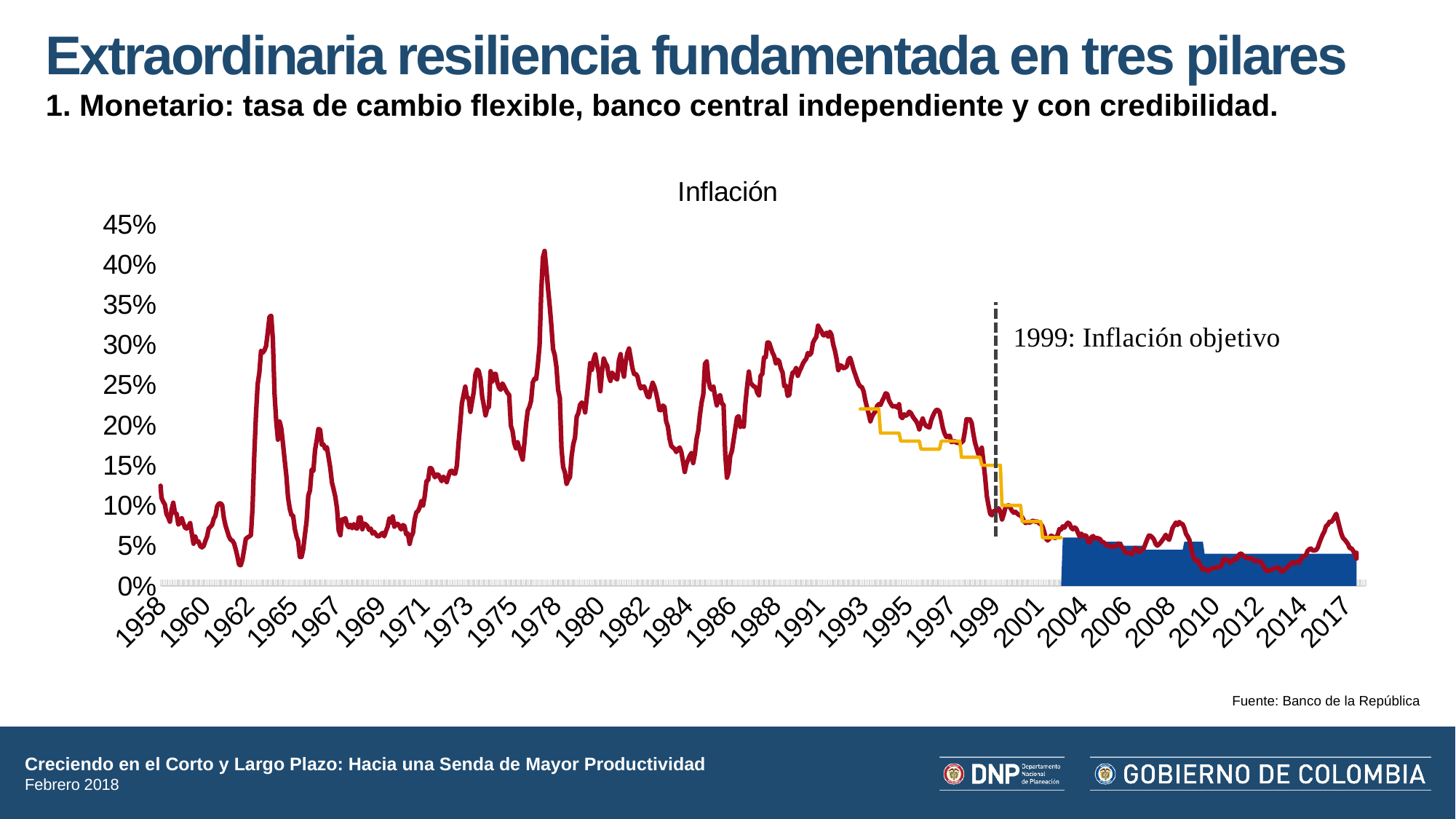
What year does the dashed vertical line on the chart mark? 1999 Does the inflation line generally rise or fall between 1991 and 2017? fall What is the highest value shown on the vertical axis of the chart? 45% Is the peak value of the red inflation line greater or less than 40%? greater What kind of chart is shown on the slide? Line chart What is the last year labelled on the horizontal axis? 2017 What is the first year labelled on the horizontal axis? 1958 What is the title of the chart? Inflación Is the inflation value at the end of the series in 2017 greater or less than 5%? less Is the inflation value around 1991 greater or less than 25%? greater